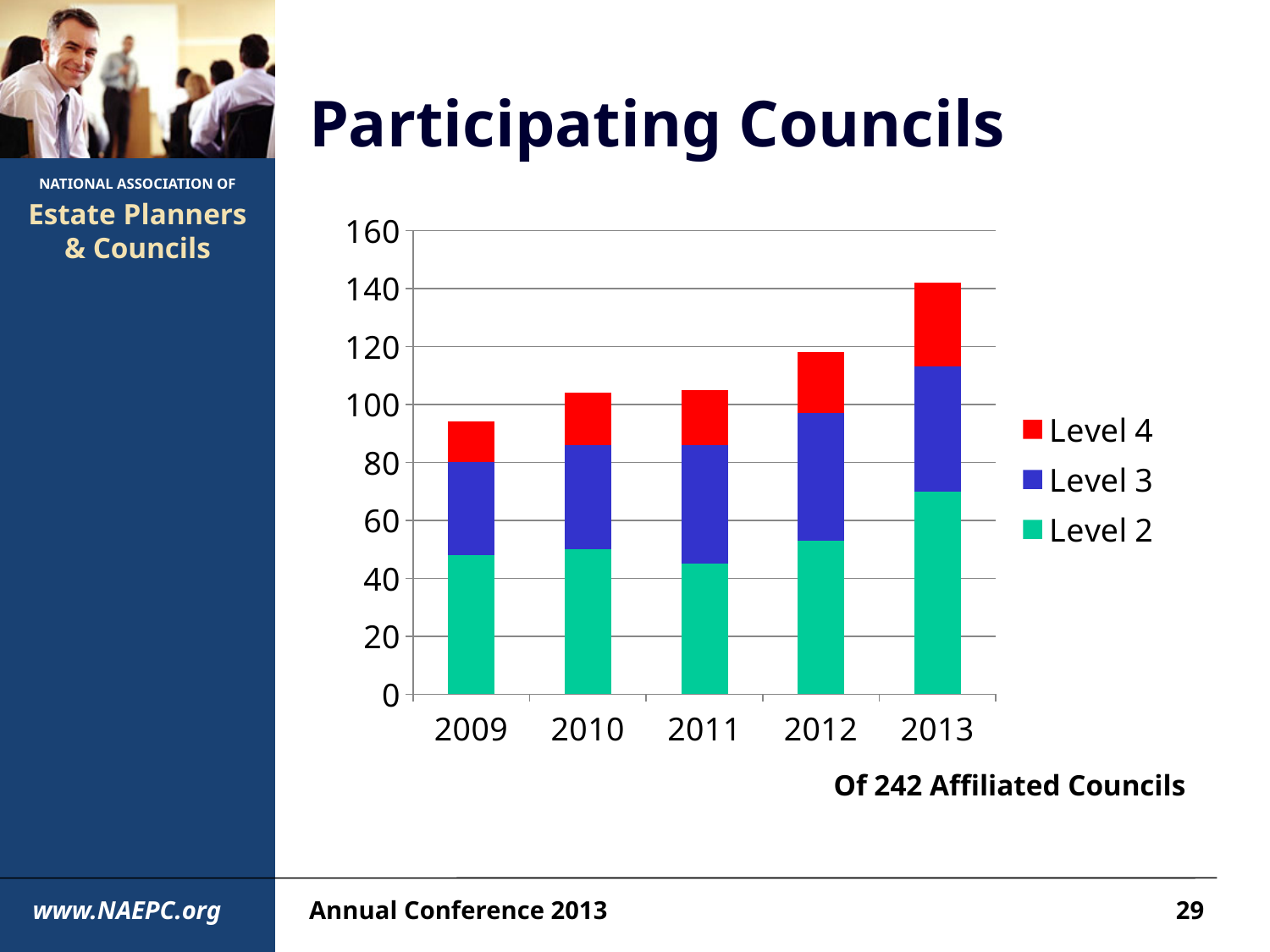
Which series is shown in red in the chart legend? Level 4 Which year has the highest total number of participating councils? 2013 Is the total for 2013 greater or less than 120? greater Is the Level 2 value for 2013 greater or less than 60? greater Is the total for 2009 greater or less than 100? less How many years are shown on the x axis of the chart? 5 Which year has the larger total, 2012 or 2013? 2013 What kind of chart is shown on the slide? Stacked bar chart How many series does the chart legend list? 3 Which year has the lowest total number of participating councils? 2009 Do the total participating councils generally rise or fall from 2009 to 2013? rise